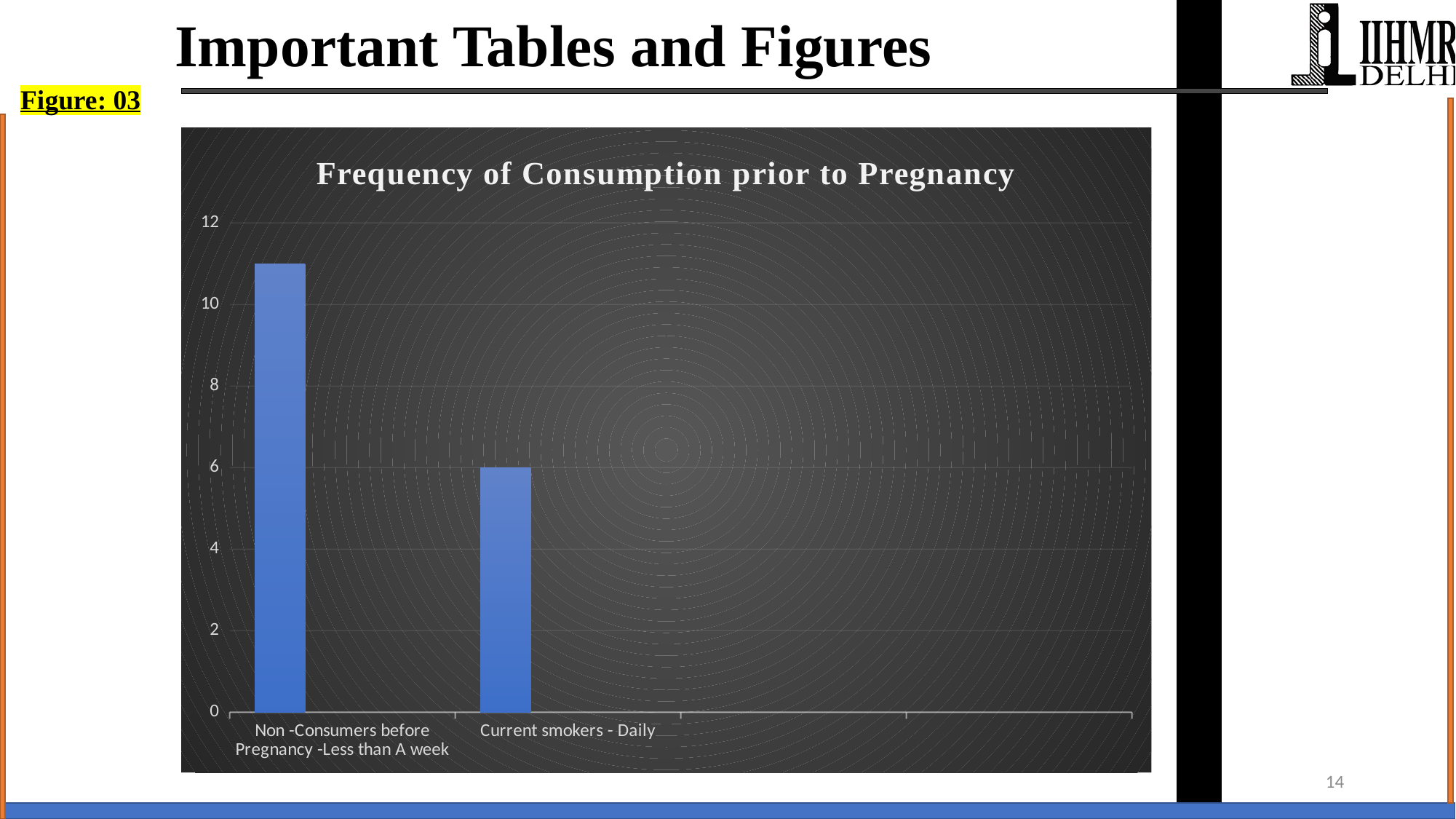
Is the value for Non -Consumers before Pregnancy -Less than A week greater or less than 10? greater What is the maximum value shown on the vertical axis? 12 Do the bar values rise or fall from left to right along the x axis? fall Is the value for Current smokers - Daily greater or less than 8? less How many bars are plotted in the chart? 2 What kind of chart is shown on the slide? bar chart Is the value for Non -Consumers before Pregnancy -Less than A week greater or less than 12? less Which is larger: the value for Non -Consumers before Pregnancy -Less than A week or the value for Current smokers - Daily? Non -Consumers before Pregnancy -Less than A week Which category has the highest value? Non -Consumers before Pregnancy -Less than A week Which category has the lowest value? Current smokers - Daily What is the value for Current smokers - Daily? 6 What is the title of the chart? Frequency of Consumption prior to Pregnancy